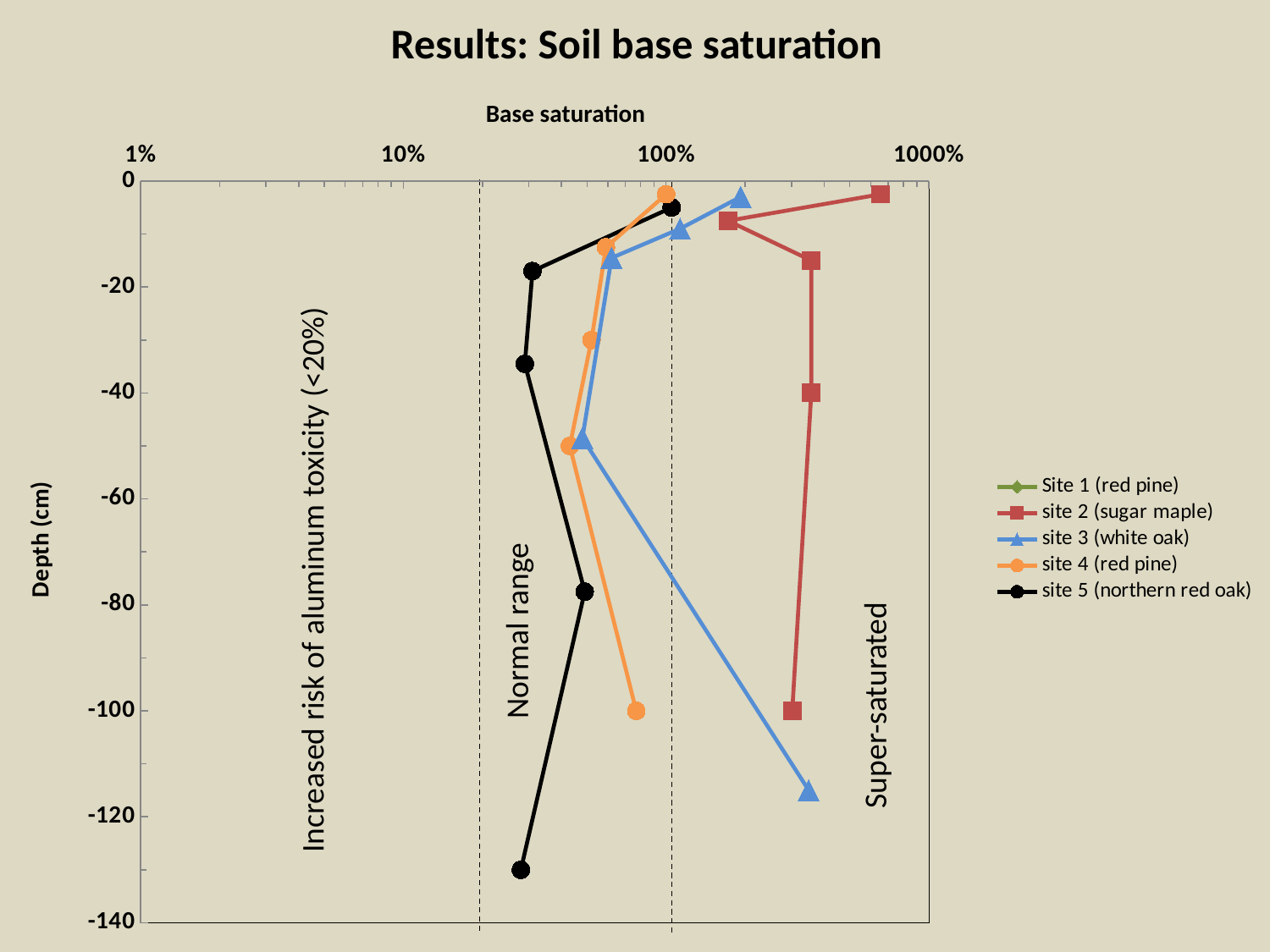
How many series does the legend list? 5 Is the base saturation for site 2 (sugar maple) at -100 cm depth greater or less than 100%? greater What is the label of the vertical axis? Depth (cm) Near the surface (shallowest point), which has the larger base saturation: site 2 (sugar maple) or site 5 (northern red oak)? site 2 (sugar maple) What kind of chart is shown on the slide? line chart At -100 cm depth, which has the larger base saturation: site 2 (sugar maple) or site 4 (red pine)? site 2 (sugar maple) Is the base saturation for site 3 (white oak) at its deepest point greater or less than 100%? greater Which series has the highest base saturation value anywhere on the chart? site 2 (sugar maple) Is the base saturation for site 5 (northern red oak) at -130 cm depth greater or less than 100%? less Which series reaches the deepest depth on the chart? site 5 (northern red oak) How many data points are plotted for site 5 (northern red oak)? 5